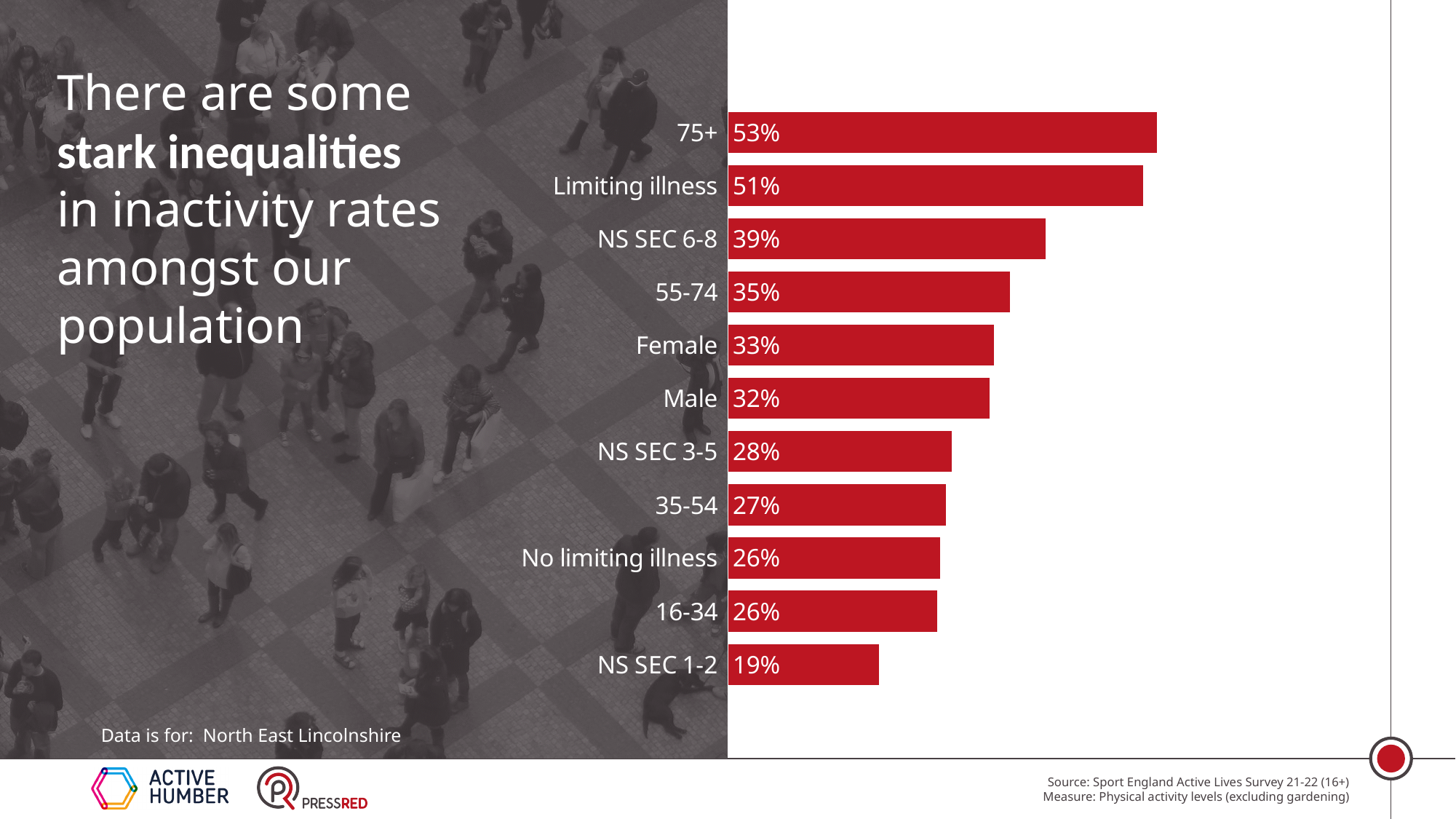
Which category has the highest inactivity rate? 75+ Which area is the data on the slide for? North East Lincolnshire What kind of chart is shown on the slide? Bar chart What is the difference in inactivity rate between NS SEC 6-8 and NS SEC 1-2? 20% What is the inactivity rate for people with a limiting illness? 51% What is the inactivity rate for the 75+ group? 53% How many categories are shown in the chart? 11 Which category has the lowest inactivity rate? NS SEC 1-2 What is the inactivity rate for NS SEC 1-2? 19% What is the difference in inactivity rate between the 75+ group and the 16-34 group? 27% Which has a higher inactivity rate, Limiting illness or No limiting illness? Limiting illness What is the inactivity rate for Female? 33%